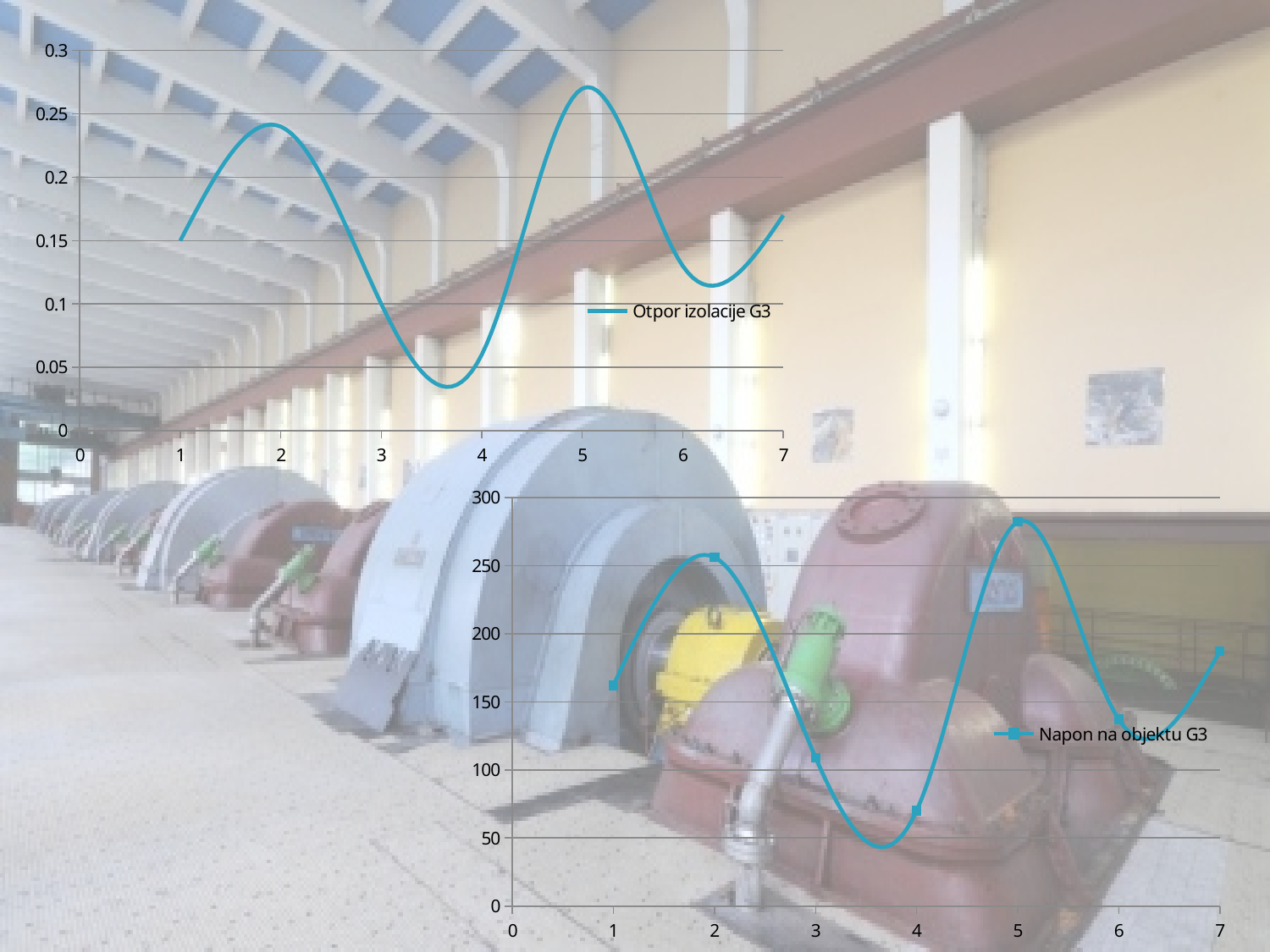
What kind of chart is the bottom chart, labelled 'Napon na objektu G3'? line chart What kind of chart is the top chart, labelled 'Otpor izolacije G3'? line chart In the top chart 'Otpor izolacije G3', at which x value is the plotted value highest? 5 In the bottom chart 'Napon na objektu G3', is the value at x = 4 greater or less than 100? less In the top chart 'Otpor izolacije G3', is the value at x = 2 greater or less than 0.2? greater In the bottom chart 'Napon na objektu G3', at which x value is the plotted value highest? 5 In the bottom chart, what series name does the legend show? Napon na objektu G3 How many series does the legend of the bottom chart list? 1 In the top chart, what series name does the legend show? Otpor izolacije G3 In the bottom chart 'Napon na objektu G3', at which x value is the plotted value lowest? 4 In the bottom chart 'Napon na objektu G3', how many data points are plotted? 7 In the bottom chart 'Napon na objektu G3', is the value at x = 2 greater or less than 200? greater